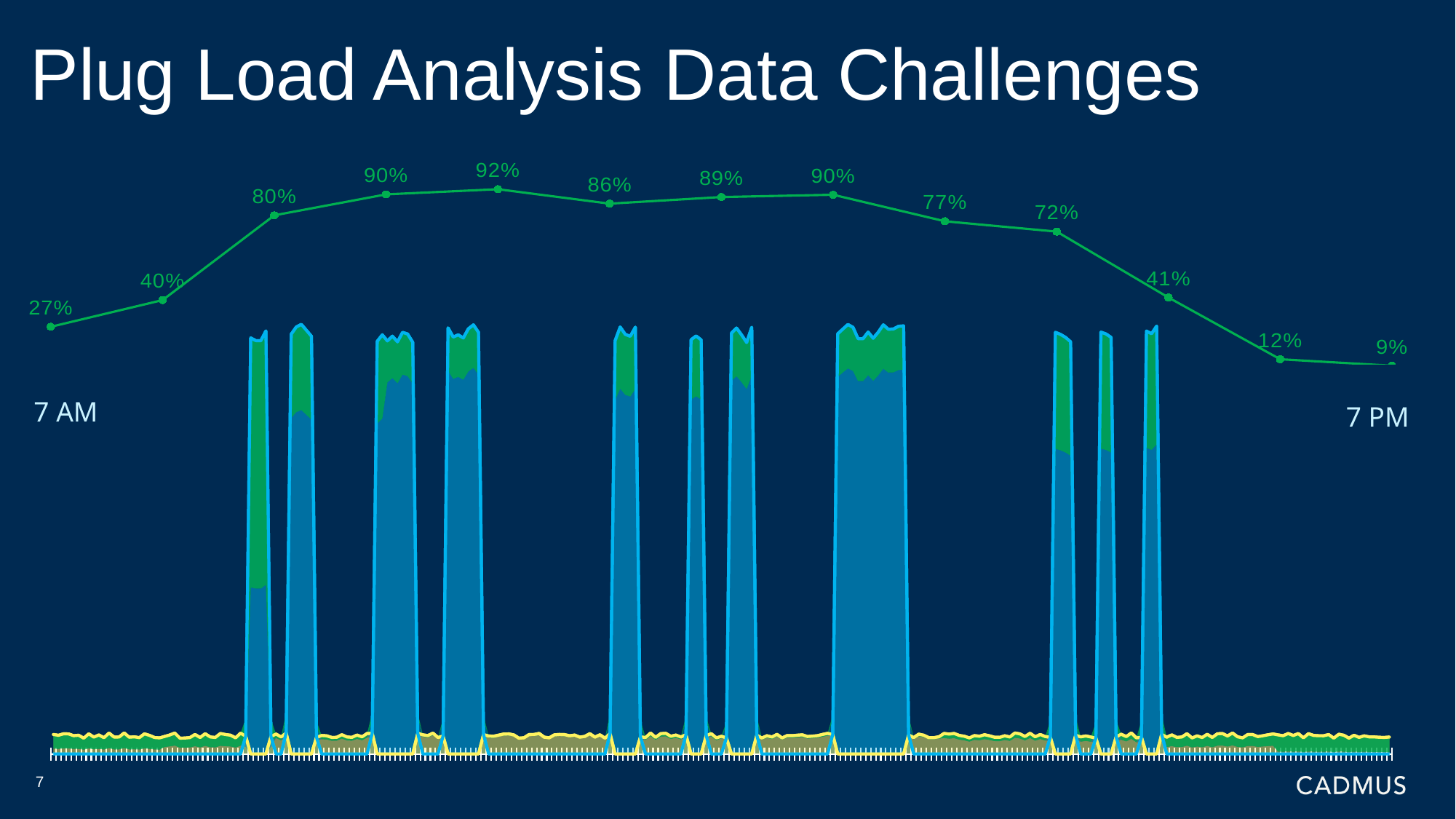
What is the highest value labelled on the green line? 92% What is the difference between the highest labelled value (92%) and the lowest labelled value (9%) on the green line? 83 percentage points How many labelled data points are on the green line? 13 What is the difference between the first labelled value (27%) and the second labelled value (40%) on the green line? 13 percentage points What kind of chart is the green percentage series drawn as? line chart Which is larger on the green line: the value at 7 AM (27%) or the value at 7 PM (9%)? 7 AM (27%) What time labels mark the start and end of the x axis? 7 AM and 7 PM Does the green line rise or fall over its last five labelled points, from 72% to 9%? fall What is the lowest value labelled on the green line? 9% What is the value of the first labelled point on the green line, at 7 AM? 27% What is the value of the last labelled point on the green line, at 7 PM? 9% Does the green line rise or fall between the first point (27%) and the fifth point (92%)? rise